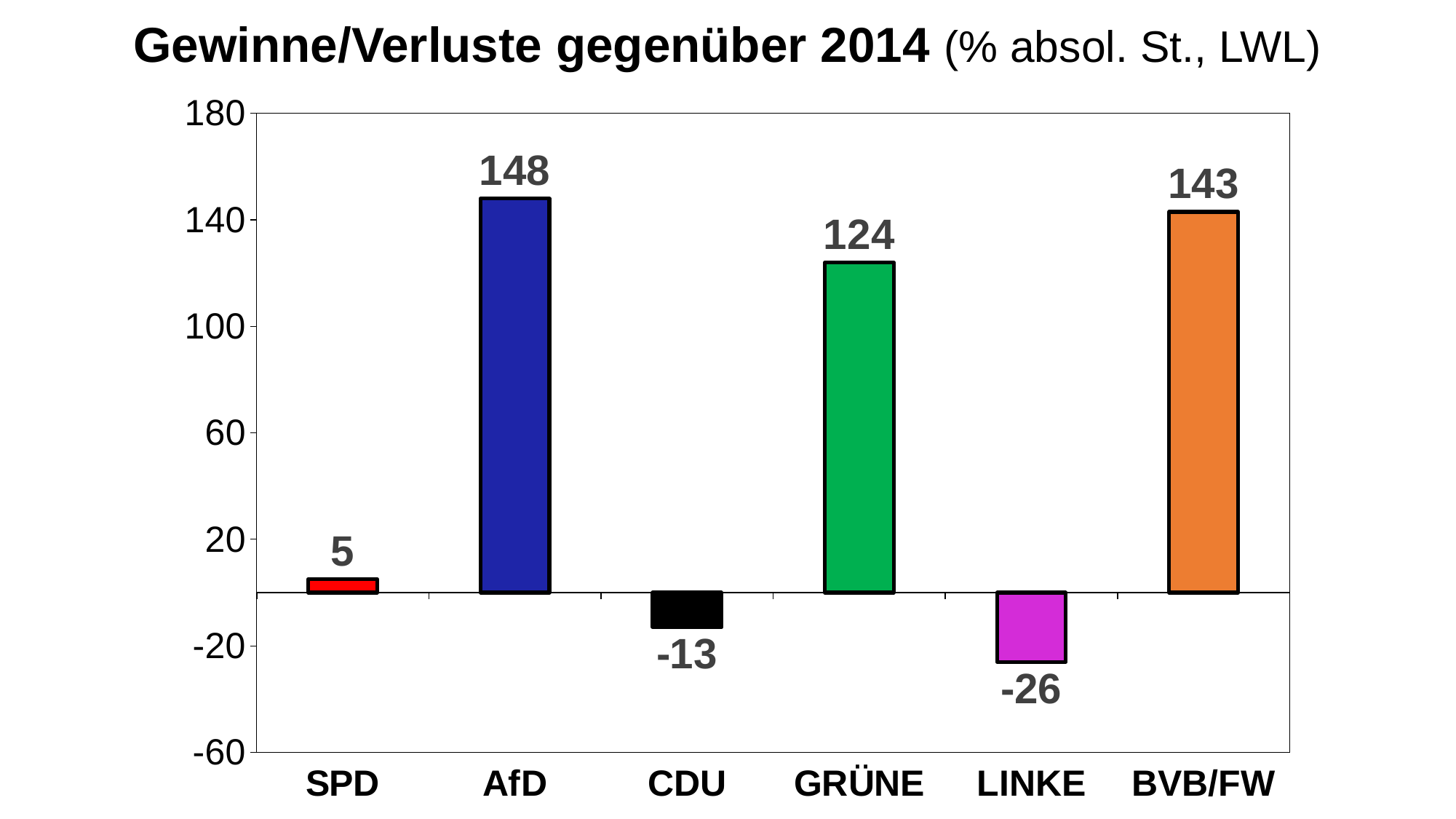
Which party has the highest value? AfD Which party has the lowest value? LINKE What is the difference between the values for GRÜNE and CDU? 137 Which is larger, the value for GRÜNE or the value for BVB/FW? BVB/FW What is the title of the chart? Gewinne/Verluste gegenüber 2014 (% absol. St., LWL) What is the value for AfD? 148 What is the value for CDU? -13 What is the value for LINKE? -26 What is the value for SPD? 5 What kind of chart is this? bar chart How many parties are shown on the x axis? 6 What is the difference between the values for AfD and BVB/FW? 5